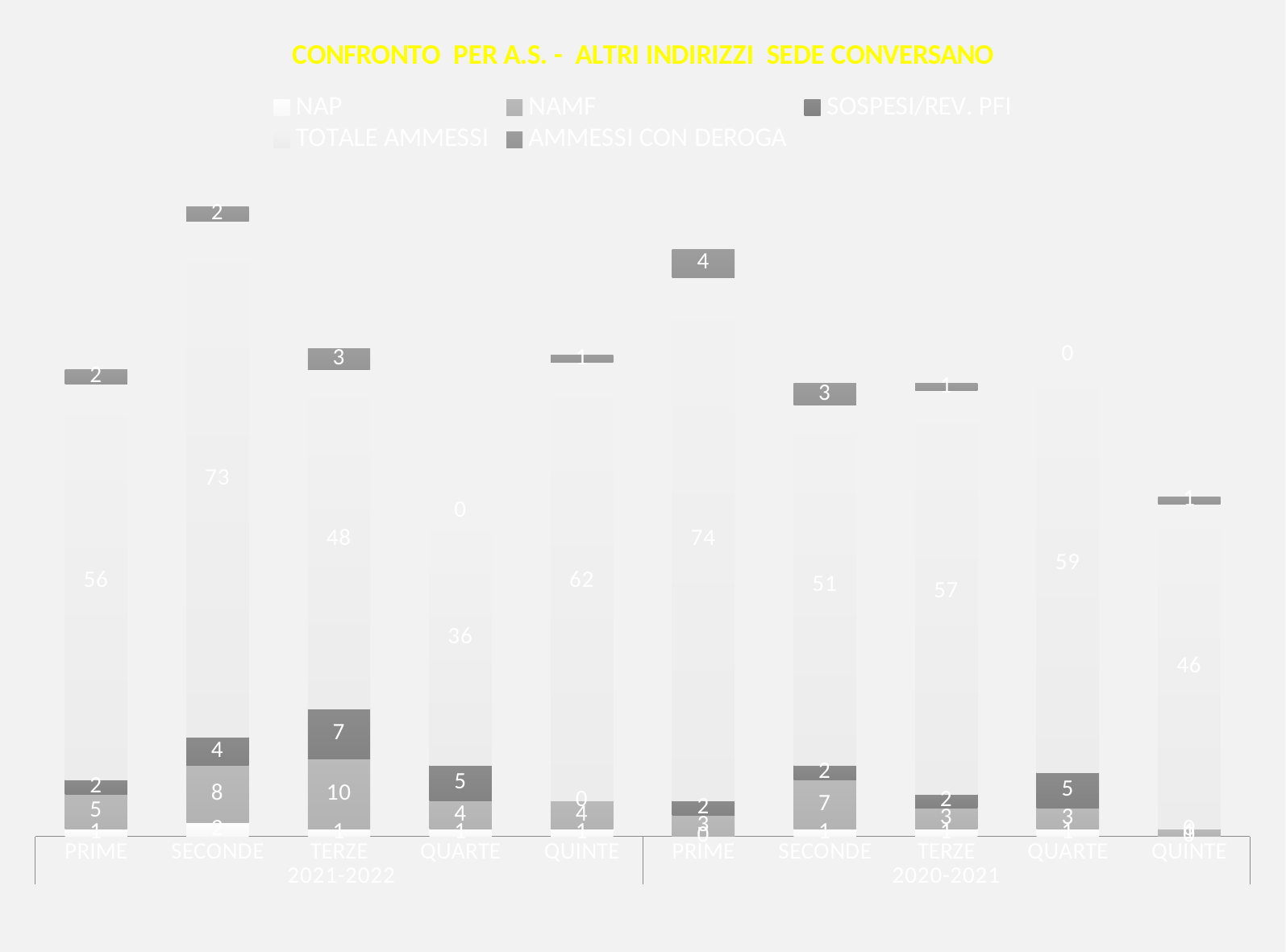
Which class in 2021-2022 has the highest TOTALE AMMESSI value? SECONDE What is the SOSPESI/REV. PFI value for TERZE in 2021-2022? 7 Which class in 2021-2022 has the lowest TOTALE AMMESSI value? QUARTE What kind of chart is shown on the slide? bar chart What is the AMMESSI CON DEROGA value for PRIME in 2020-2021? 4 Which is larger, the TOTALE AMMESSI value for TERZE in 2021-2022 or for TERZE in 2020-2021? TERZE in 2020-2021 What is the NAMF value for TERZE in 2021-2022? 10 What is the TOTALE AMMESSI value for PRIME in 2020-2021? 74 What is the difference between the TOTALE AMMESSI value for PRIME in 2020-2021 and PRIME in 2021-2022? 18 How many class categories are shown on the x axis in total across both school years? 10 How many series does the legend list? 5 What is the TOTALE AMMESSI value for SECONDE in 2021-2022? 73